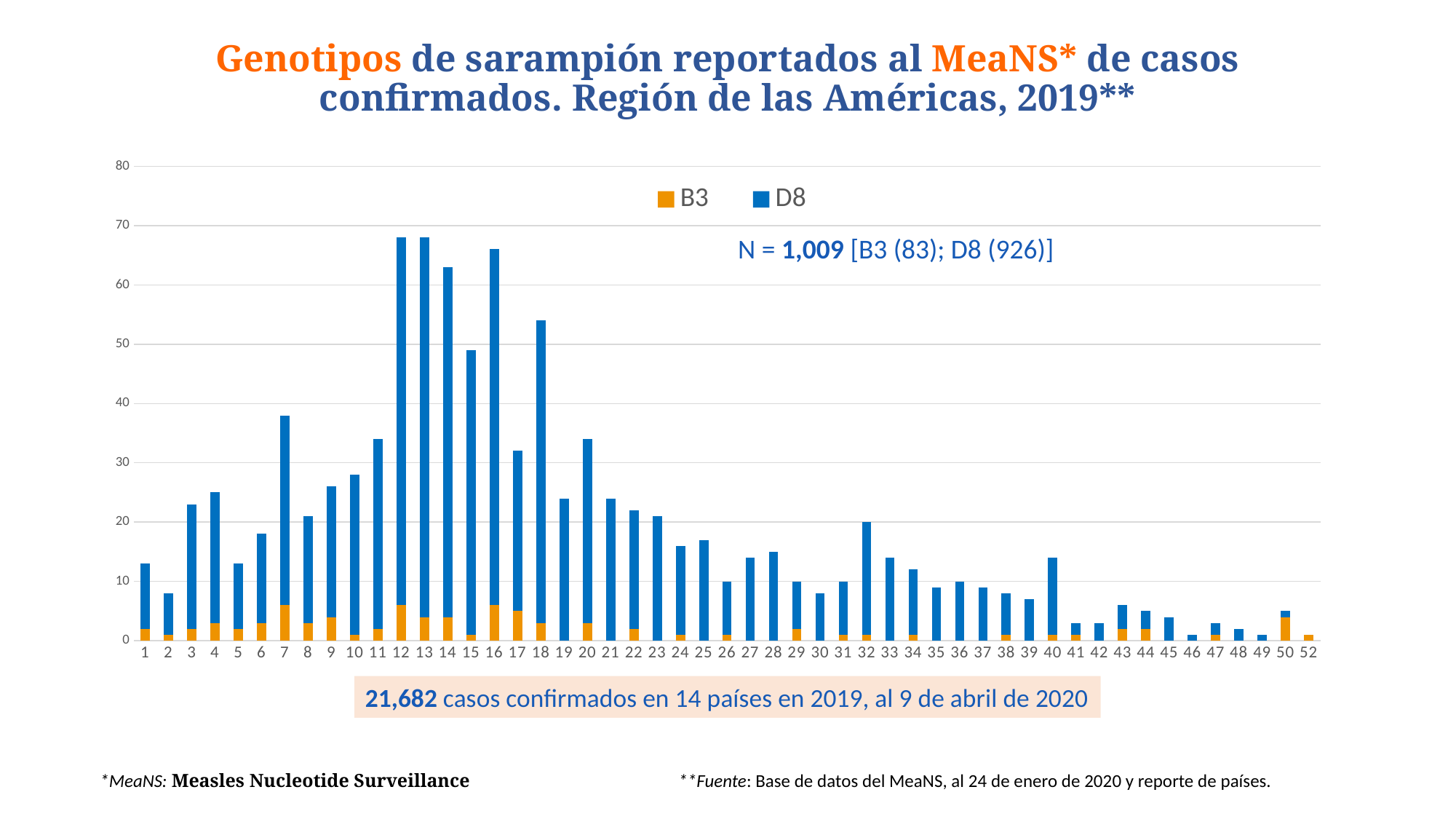
Which colour represents the B3 genotype in the chart? orange How many week categories are shown on the x axis? 51 What kind of chart is shown on the slide? bar chart Which week has the taller bar, week 7 or week 8? week 7 Is the total value for week 46 greater or less than 10? less Is the total value for week 2 greater or less than 10? less Do the bar heights generally rise or fall from week 16 to week 30? fall How many series does the legend list? 2 What are the two series named in the legend? B3 and D8 Which week has the taller bar, week 12 or week 40? week 12 Is the total value for week 12 greater or less than 60? greater